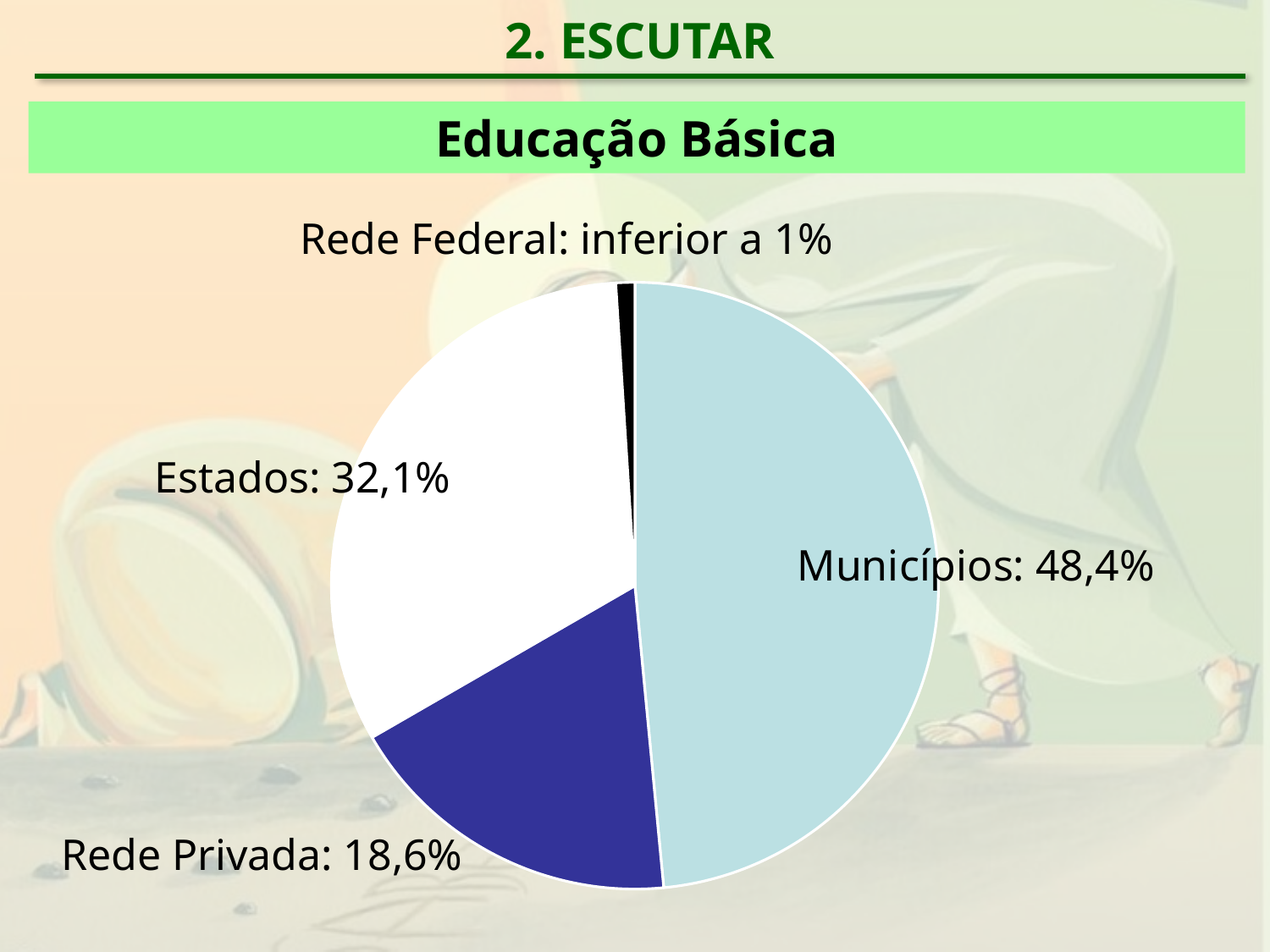
What is the value shown for Rede Privada in the pie chart? 18,6% Which category has the smallest slice of the pie chart? Rede Federal What kind of chart is shown on the slide? Pie chart What is the difference in percentage points between Estados and Rede Privada? 13,5 What is the difference in percentage points between Municípios and Estados? 16,3 Which category has the largest slice of the pie chart? Municípios What is the value shown for Estados in the pie chart? 32,1% What is the title shown in the green banner above the chart? Educação Básica What share of Educação Básica does Municípios account for in the pie chart? 48,4% What does the chart say about the share of Rede Federal? inferior a 1% How many categories are shown in the pie chart? 4 Which is larger, the share for Estados or the share for Rede Privada? Estados